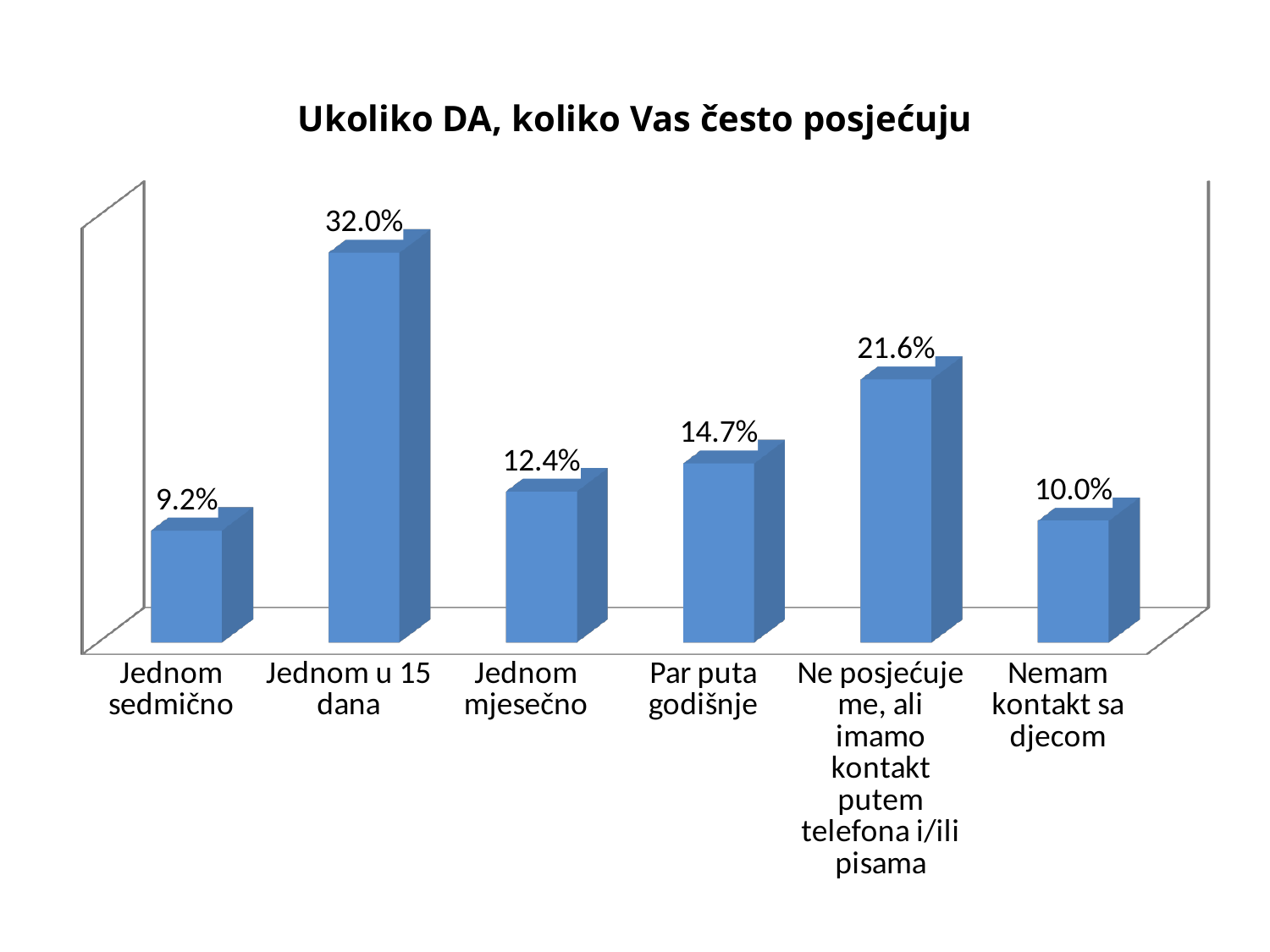
Which is larger, the value for "Jednom mjesečno" or the value for "Par puta godišnje"? Par puta godišnje What is the title of the chart? Ukoliko DA, koliko Vas često posjećuju Which category has the highest value? Jednom u 15 dana How many categories are shown in the chart? 6 What is the value for "Jednom sedmično"? 9.2% What is the value for "Jednom u 15 dana"? 32.0% Which category has the lowest value? Jednom sedmično What is the difference between the values for "Jednom u 15 dana" and "Ne posjećuje me, ali imamo kontakt putem telefona i/ili pisama"? 10.4% What kind of chart is shown on the slide? Bar chart What is the value for "Par puta godišnje"? 14.7% What is the difference between the values for "Nemam kontakt sa djecom" and "Jednom sedmično"? 0.8% What is the value for "Nemam kontakt sa djecom"? 10.0%